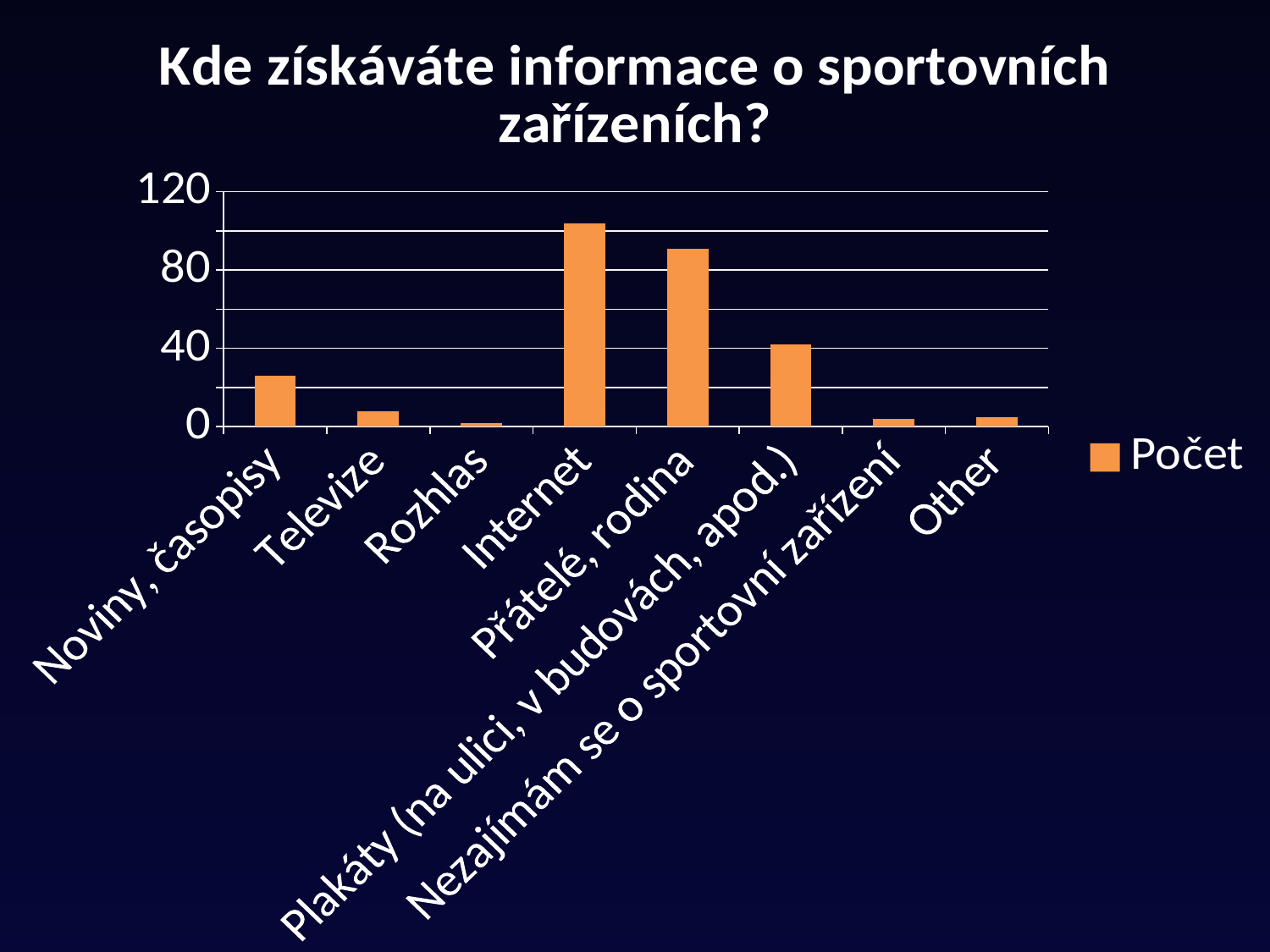
What is the title of the chart? Kde získáváte informace o sportovních zařízeních? Which category has the lowest value? Rozhlas How many categories are shown on the x axis of the chart? 8 Which has a larger value, Internet or Přátelé, rodina? Internet Is the value for Internet greater or less than 80? greater Is the value for Plakáty (na ulici, v budovách, apod.) greater or less than 80? less Is the value for Noviny, časopisy greater or less than 40? less What is the name of the series shown in the legend? Počet What kind of chart is shown on the slide? bar chart Which has a larger value, Noviny, časopisy or Televize? Noviny, časopisy How many series does the legend list? 1 Which category has the highest value? Internet